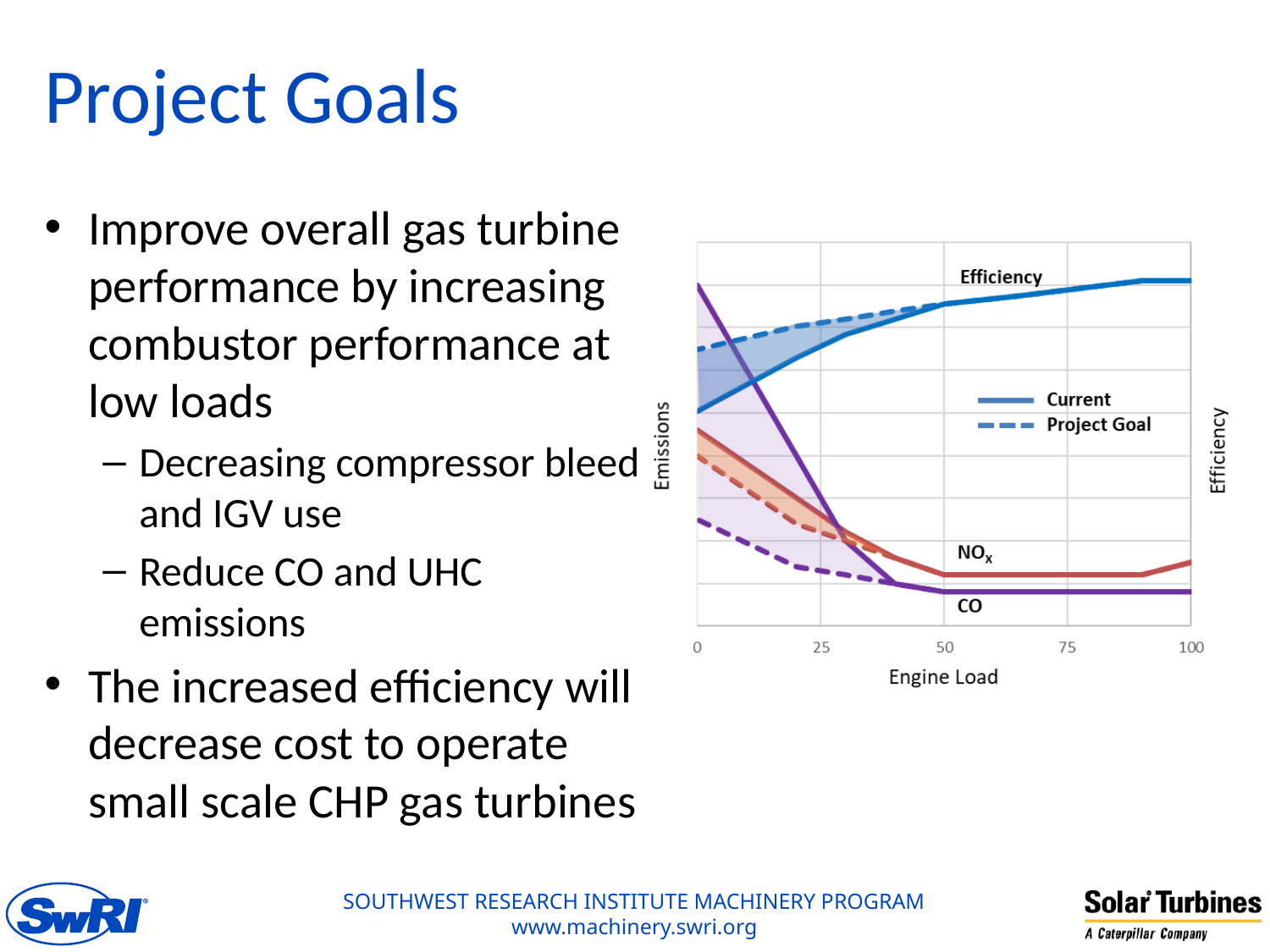
How many tick values are shown on the Engine Load axis? 5 Does the CO line rise or fall as Engine Load increases from 0 to 50? Falls At an Engine Load of 0, which is higher on the chart, the CO line or the NOx line? CO What is the highest Engine Load value shown on the x axis? 100 What is the label of the x axis of the chart? Engine Load Which line style represents the Project Goal in the chart? Dashed Which of the three labeled curves is plotted against the Efficiency axis? Efficiency Does the Efficiency line rise or fall as Engine Load increases? Rises How many entries does the chart's legend list? 2 Does the NOx line rise or fall as Engine Load increases from 0 to 50? Falls What kind of chart is shown on the slide? Line chart